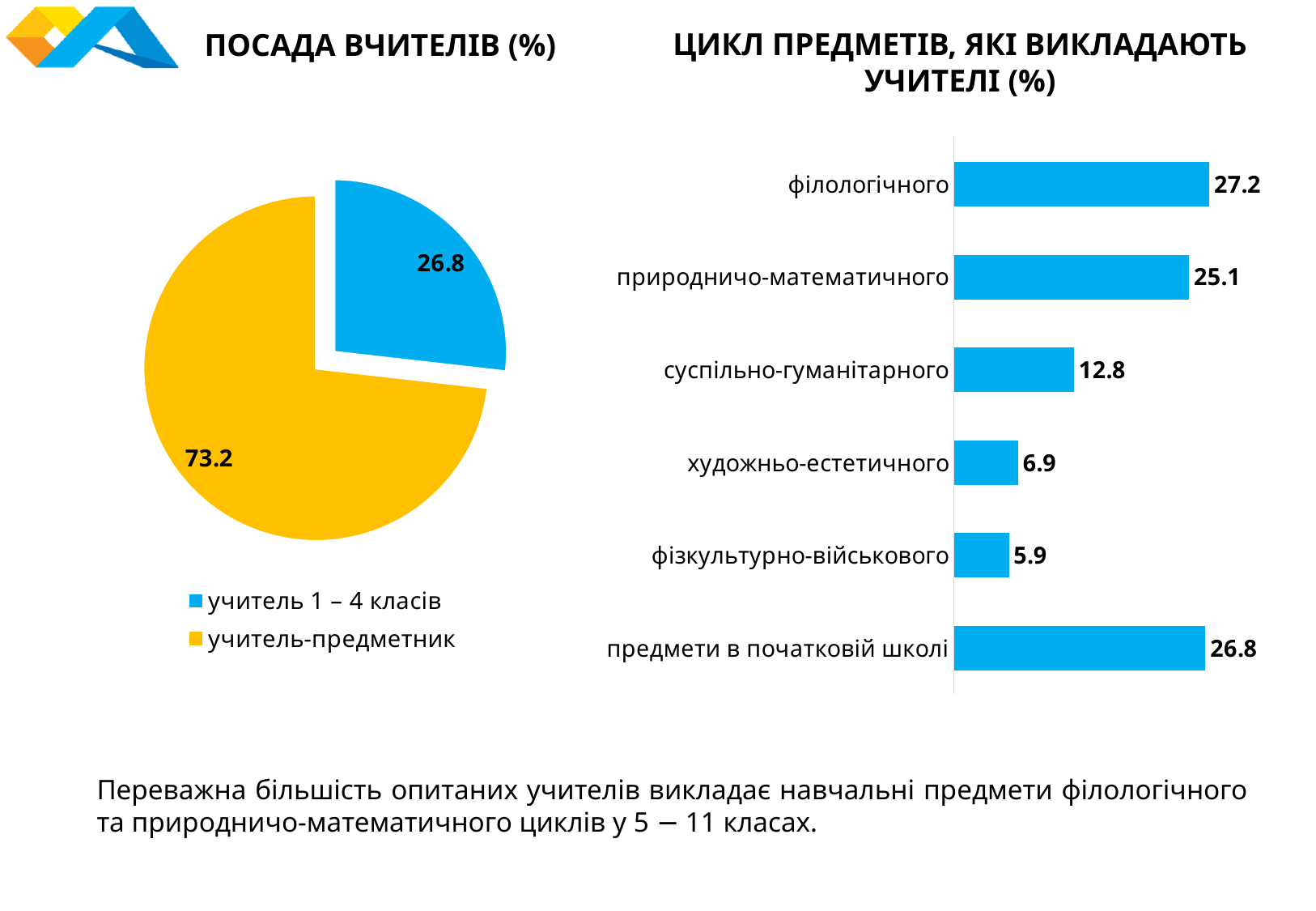
In the bar chart 'ЦИКЛ ПРЕДМЕТІВ, ЯКІ ВИКЛАДАЮТЬ УЧИТЕЛІ (%)', which category has the lowest value? фізкультурно-військового In the pie chart 'ПОСАДА ВЧИТЕЛІВ (%)', what is the difference between 'учитель-предметник' and 'учитель 1 – 4 класів'? 46.4 In the bar chart 'ЦИКЛ ПРЕДМЕТІВ, ЯКІ ВИКЛАДАЮТЬ УЧИТЕЛІ (%)', how many categories are shown? 6 What kind of chart is the chart on the left, 'ПОСАДА ВЧИТЕЛІВ (%)'? pie chart What kind of chart is the chart on the right, 'ЦИКЛ ПРЕДМЕТІВ, ЯКІ ВИКЛАДАЮТЬ УЧИТЕЛІ (%)'? bar chart In the pie chart 'ПОСАДА ВЧИТЕЛІВ (%)', what is the value for 'учитель-предметник'? 73.2 In the bar chart 'ЦИКЛ ПРЕДМЕТІВ, ЯКІ ВИКЛАДАЮТЬ УЧИТЕЛІ (%)', which category has the highest value? філологічного In the bar chart 'ЦИКЛ ПРЕДМЕТІВ, ЯКІ ВИКЛАДАЮТЬ УЧИТЕЛІ (%)', what is the value for 'філологічного'? 27.2 In the bar chart 'ЦИКЛ ПРЕДМЕТІВ, ЯКІ ВИКЛАДАЮТЬ УЧИТЕЛІ (%)', what is the value for 'художньо-естетичного'? 6.9 In the bar chart 'ЦИКЛ ПРЕДМЕТІВ, ЯКІ ВИКЛАДАЮТЬ УЧИТЕЛІ (%)', what is the difference between 'природничо-математичного' and 'суспільно-гуманітарного'? 12.3 In the pie chart 'ПОСАДА ВЧИТЕЛІВ (%)', what is the value for 'учитель 1 – 4 класів'? 26.8 In the pie chart 'ПОСАДА ВЧИТЕЛІВ (%)', which category has the largest share? учитель-предметник